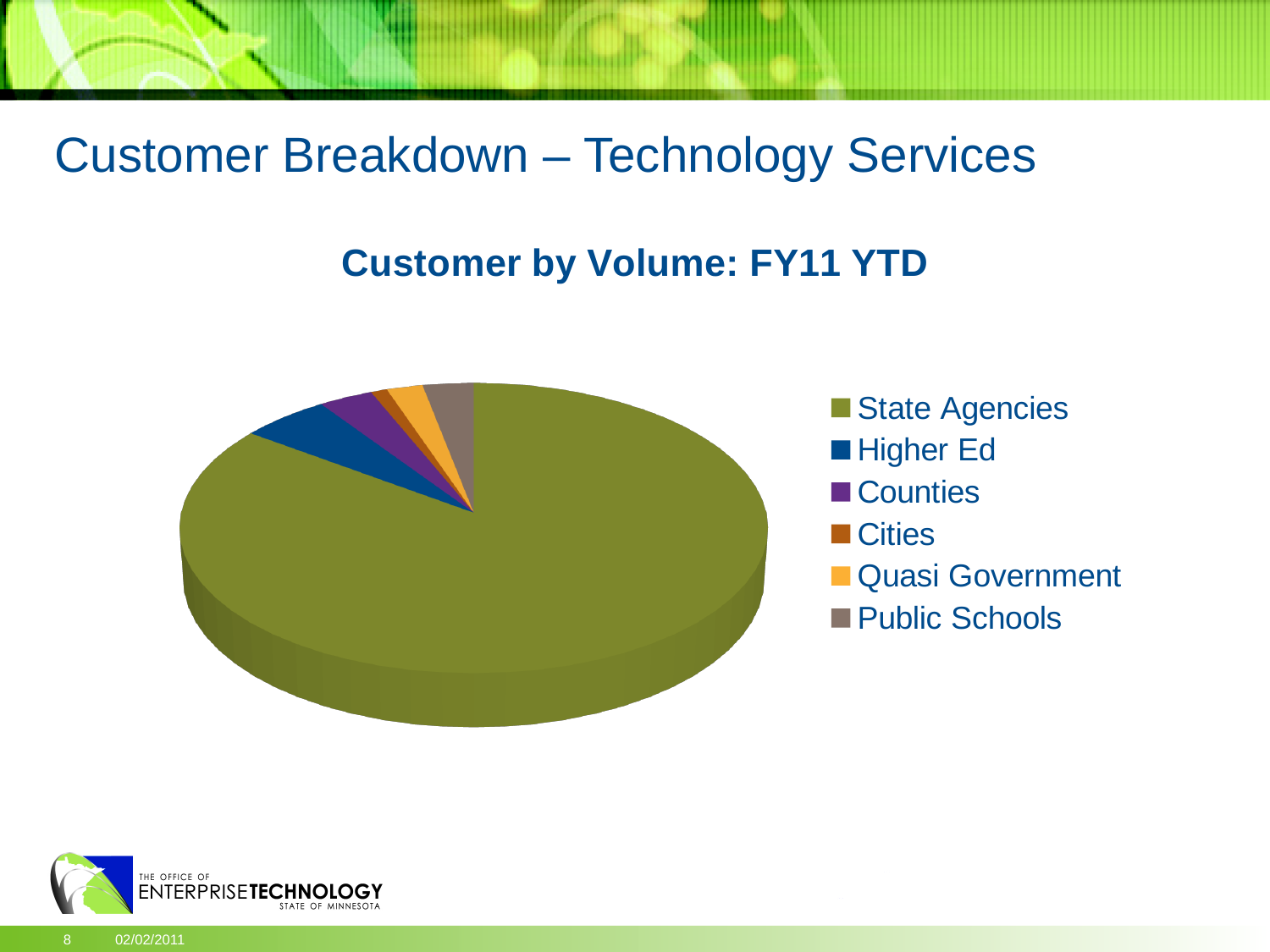
Which is larger, the slice for State Agencies or the slice for Public Schools? State Agencies Which is larger, the slice for State Agencies or the slice for Higher Ed? State Agencies What kind of chart is shown on the slide? Pie chart How many customer categories does the pie chart show? 6 Which category is listed last in the legend? Public Schools Which is larger, the slice for Higher Ed or the slice for Cities? Higher Ed What is the title of the chart? Customer by Volume: FY11 YTD Which category is represented by the blue slice? Higher Ed How many entries does the legend list? 6 Which customer category has the largest share of the pie? State Agencies